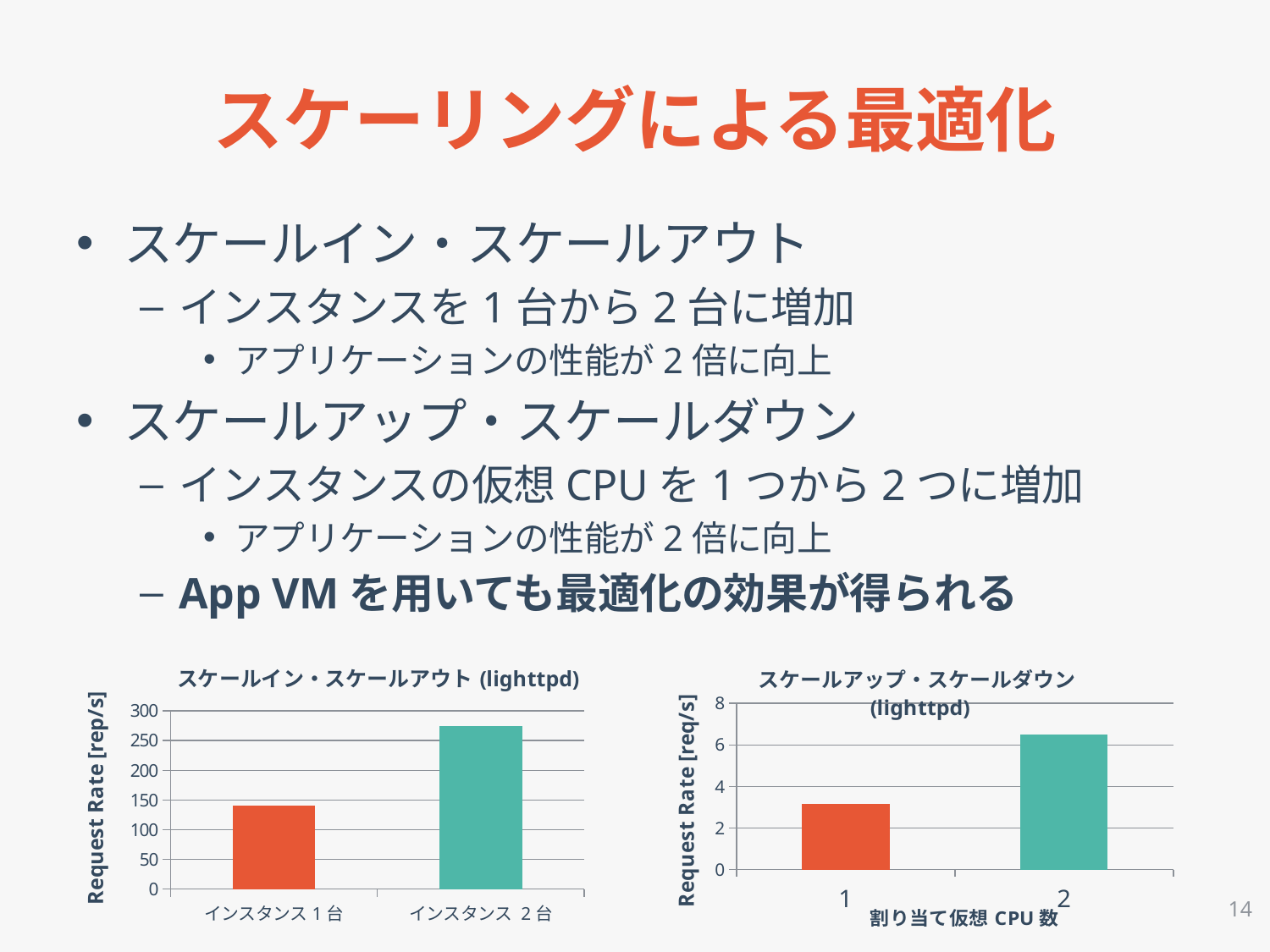
What is the x-axis label of the right chart (スケールアップ・スケールダウン)? 割り当て仮想 CPU 数 In the left chart (スケールイン・スケールアウト), which category has the higher request rate? インスタンス 2 台 What kind of chart is the right chart titled スケールアップ・スケールダウン (lighttpd)? bar chart In the left chart (スケールイン・スケールアウト), is the value for インスタンス 2 台 greater or less than 250? greater In the right chart (スケールアップ・スケールダウン), which x-axis category has the lower request rate? 1 What is the y-axis label of the left chart (スケールイン・スケールアウト)? Request Rate [rep/s] In the right chart (スケールアップ・スケールダウン), is the value for 1 CPU greater or less than 4? less How many categories are shown on the x axis of the left chart (スケールイン・スケールアウト)? 2 In the left chart (スケールイン・スケールアウト), is the value for インスタンス 1 台 greater or less than 150? less What kind of chart is the left chart titled スケールイン・スケールアウト (lighttpd)? bar chart In the right chart (スケールアップ・スケールダウン), do the values rise or fall as the number of assigned virtual CPUs increases from 1 to 2? rise